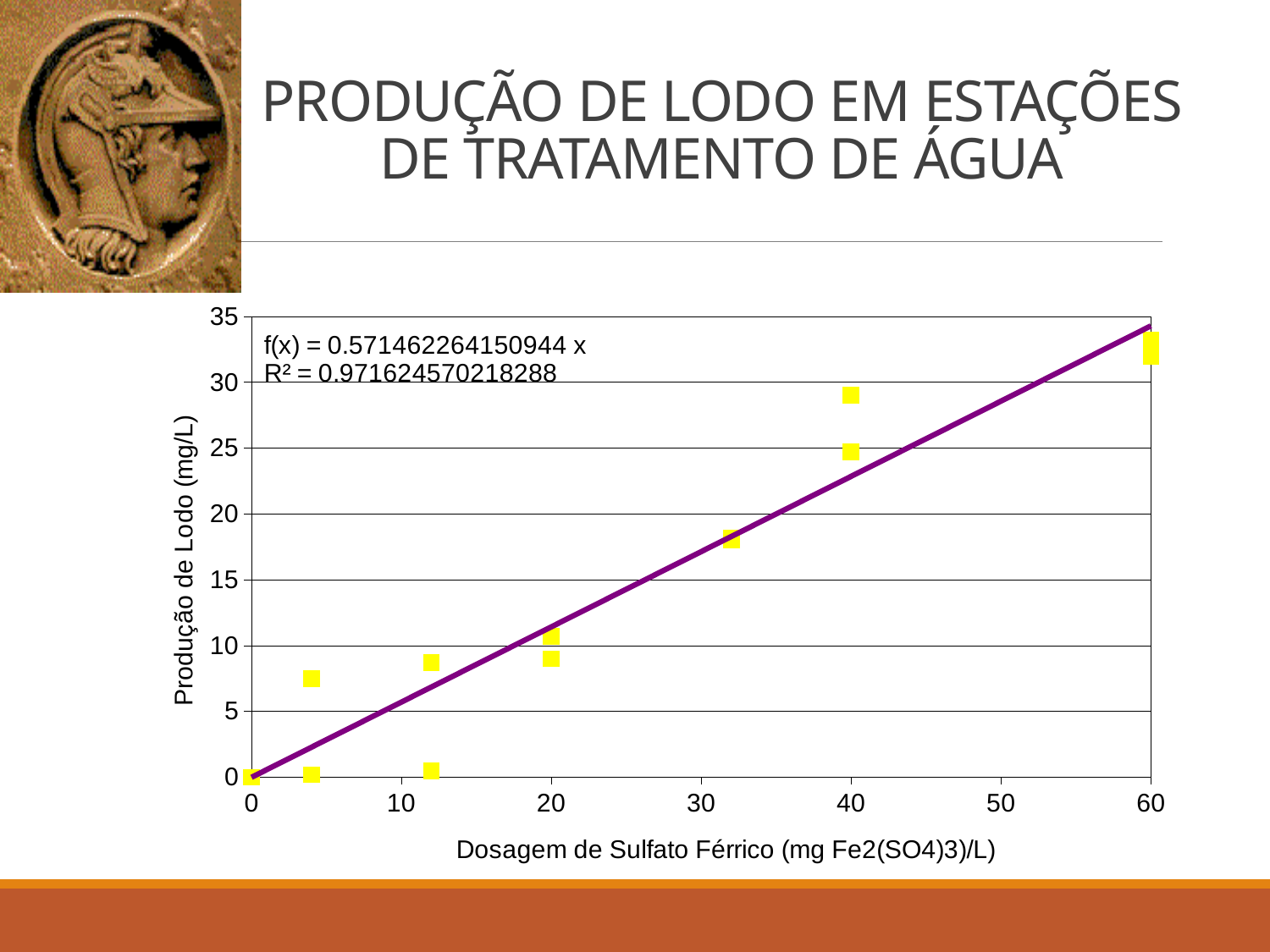
What is the title of the x axis? Dosagem de Sulfato Férrico (mg Fe2(SO4)3)/L) Is the Produção de Lodo for a dosage of 60 greater or less than 30? greater Are the Produção de Lodo values for a dosage of 20 greater or less than 15? less Are the Produção de Lodo values for a dosage of 4 greater or less than 10? less What is the title of the y axis? Produção de Lodo (mg/L) What kind of chart is shown on the slide? Scatter chart What is the equation of the trendline printed on the chart? f(x) = 0.571462264150944 x At which dosage is the highest Produção de Lodo plotted? 60 Do the plotted values of Produção de Lodo generally rise or fall as the Dosagem de Sulfato Férrico increases? Rise What R² value is printed on the chart? R² = 0.971624570218288